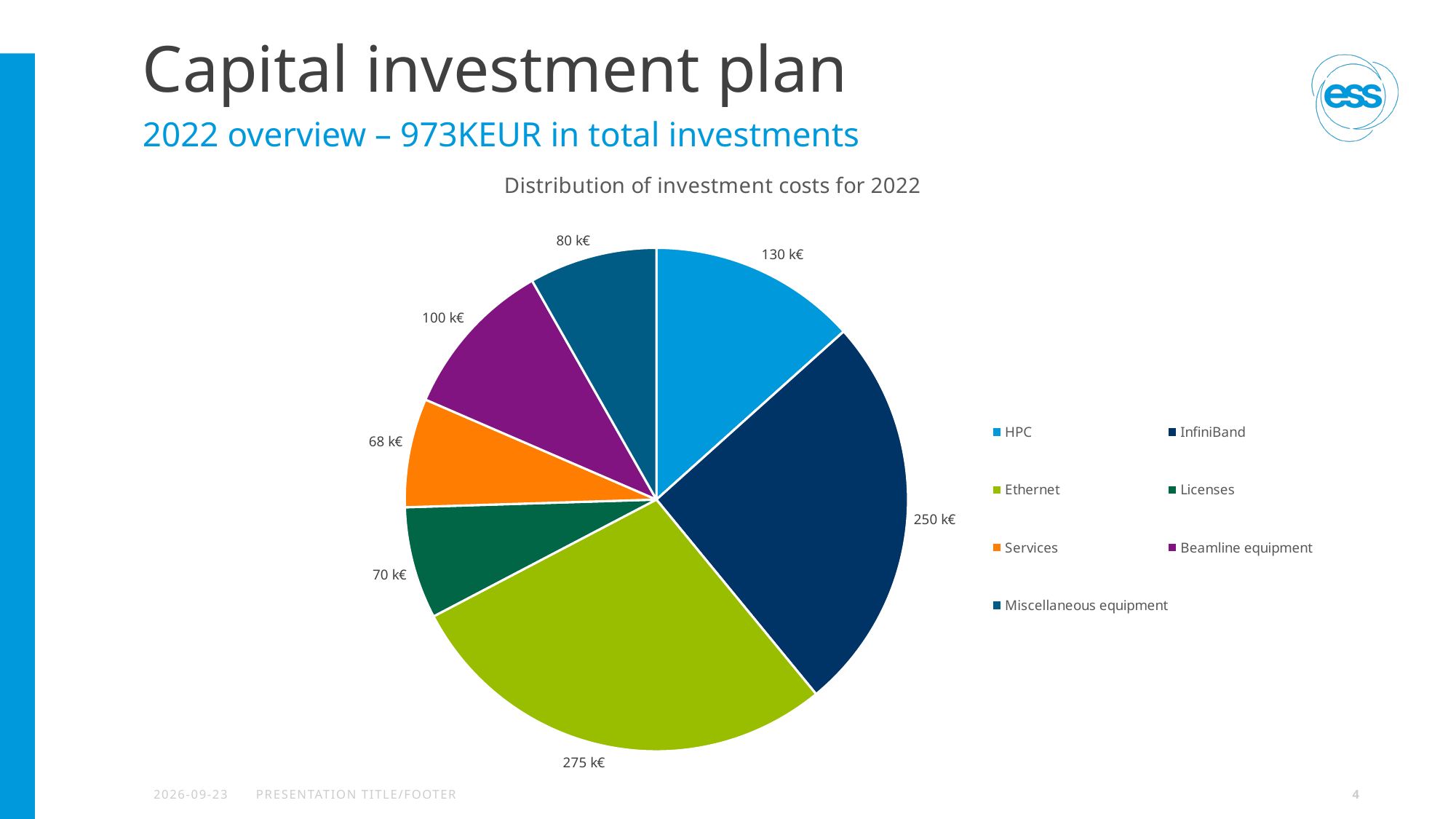
Which is larger, the investment for Licenses or for Services? Licenses What is the investment value for HPC? 130 k€ What is the investment value for Beamline equipment? 100 k€ What type of chart is shown on the slide? Pie chart What is the difference between the Ethernet and InfiniBand investments? 25 k€ How many categories does the legend list? 7 What is the title of the chart? Distribution of investment costs for 2022 What is the investment value for Ethernet? 275 k€ What is the investment value for Miscellaneous equipment? 80 k€ What is the investment value for InfiniBand? 250 k€ Which category has the smallest investment? Services Which category has the largest investment? Ethernet